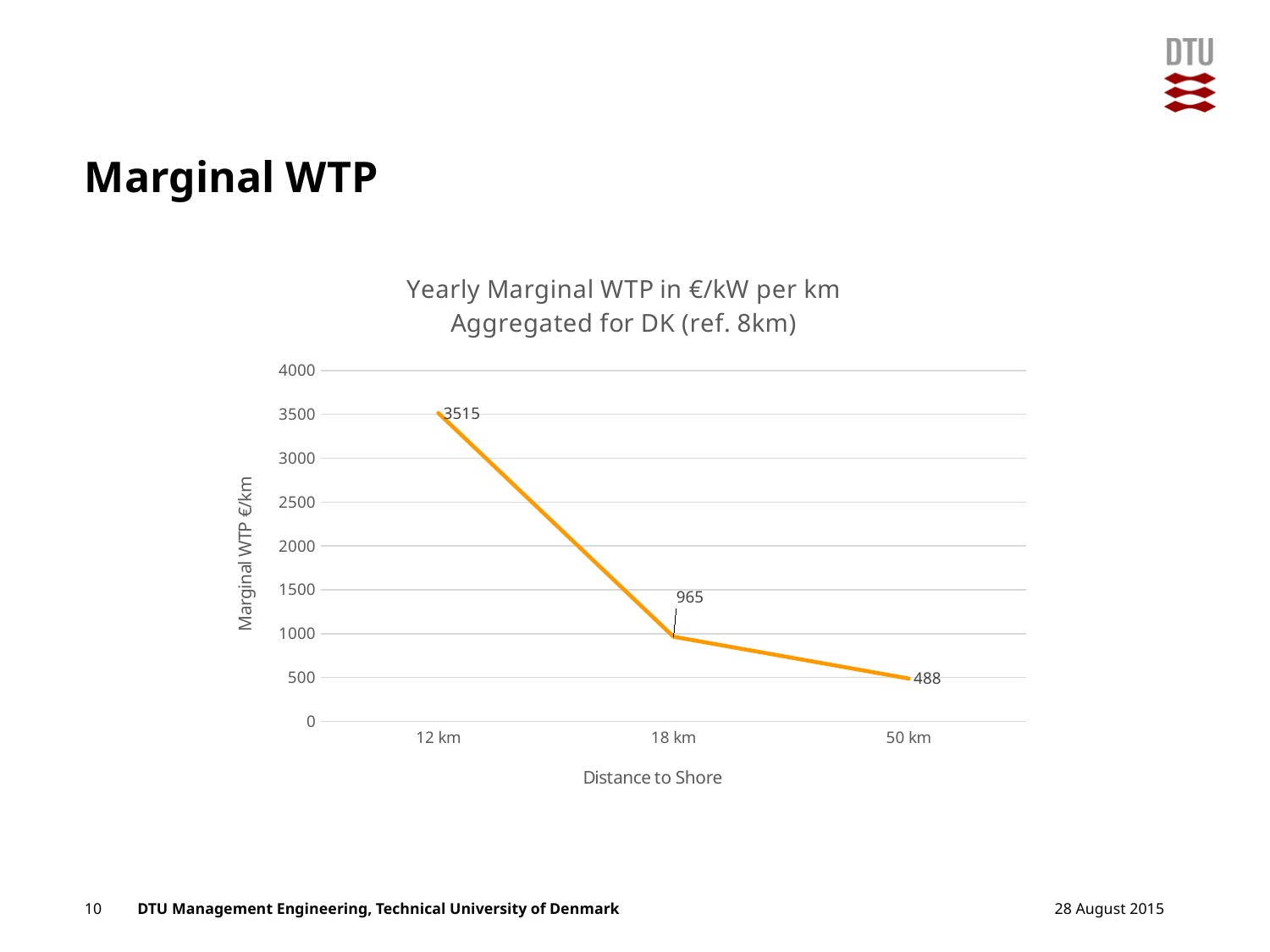
What kind of chart is shown on the slide? line chart What is the marginal WTP value at 50 km? 488 What is the difference between the marginal WTP at 18 km and at 50 km? 477 How many distance categories are plotted on the x axis? 3 What is the marginal WTP value at 18 km? 965 Which is larger, the marginal WTP at 18 km or at 50 km? 18 km Do the marginal WTP values rise or fall as distance to shore increases? fall What is the marginal WTP value at 12 km? 3515 Is the marginal WTP at 12 km greater or less than 3000? greater What is the difference between the marginal WTP at 12 km and at 18 km? 2550 Which distance to shore has the lowest marginal WTP? 50 km Which distance to shore has the highest marginal WTP? 12 km